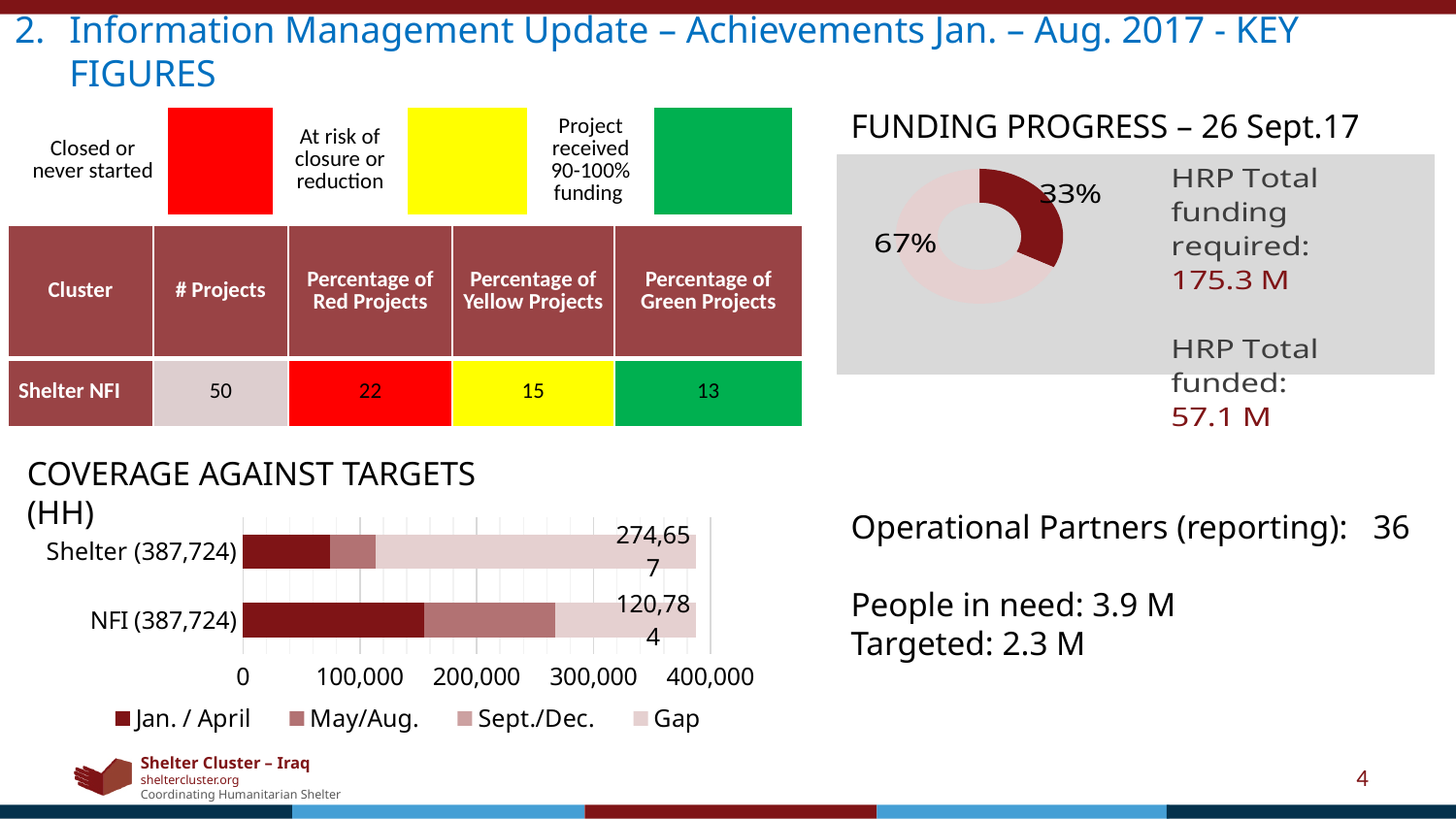
How many categories are shown on the COVERAGE AGAINST TARGETS (HH) chart? 2 How many series does the legend of the COVERAGE AGAINST TARGETS (HH) chart list? 4 How many slices does the FUNDING PROGRESS – 26 Sept.17 chart have? 2 In the COVERAGE AGAINST TARGETS (HH) chart, what data label is shown at the end of the NFI (387,724) bar? 120,784 In the FUNDING PROGRESS – 26 Sept.17 chart, which slice is larger, the 33% slice or the 67% slice? the 67% slice In the FUNDING PROGRESS – 26 Sept.17 chart, what percentage is shown for the dark red slice? 33% In the COVERAGE AGAINST TARGETS (HH) chart, is the Jan. / April value for NFI (387,724) greater or less than 100,000? greater What kind of chart is the FUNDING PROGRESS – 26 Sept.17 chart? pie (donut) chart In the FUNDING PROGRESS – 26 Sept.17 chart, what percentage is shown for the light pink slice? 67% In the COVERAGE AGAINST TARGETS (HH) chart, which category has the larger Jan. / April segment, Shelter (387,724) or NFI (387,724)? NFI (387,724) What kind of chart is the COVERAGE AGAINST TARGETS (HH) chart? bar chart In the COVERAGE AGAINST TARGETS (HH) chart, what data label is shown at the end of the Shelter (387,724) bar? 274,657